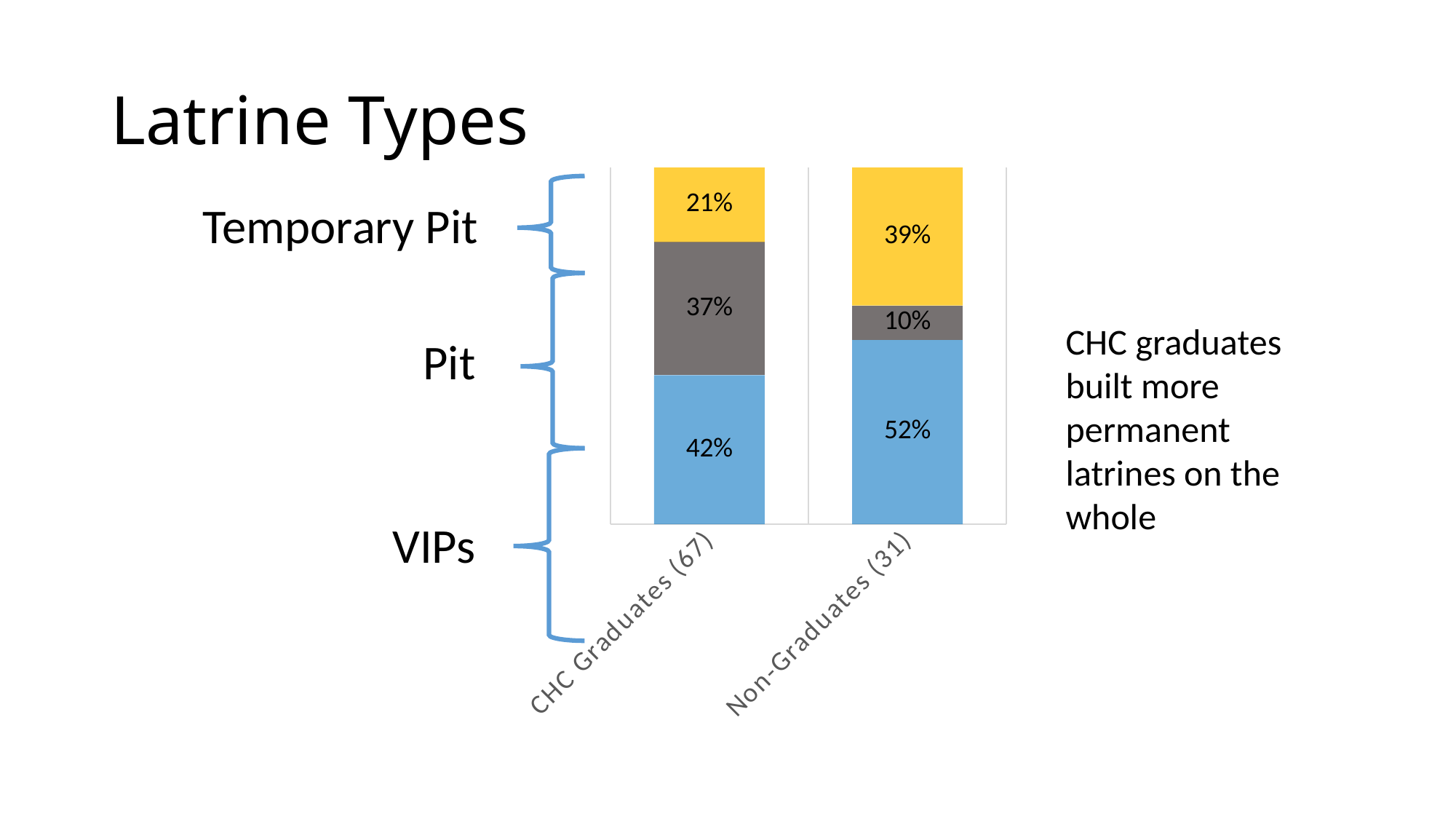
How many latrine types are stacked in each bar? 3 What type of chart is shown on the slide? Stacked bar chart What is the difference between the Temporary Pit share for Non-Graduates and for CHC Graduates? 18% What percentage of Non-Graduates built Temporary Pit latrines? 39% What percentage of CHC Graduates built Pit latrines? 37% What percentage of Non-Graduates built Pit latrines? 10% What is the difference between the Pit share for CHC Graduates and for Non-Graduates? 27% Which latrine type has the largest share among CHC Graduates? VIPs Which group has the higher share of VIPs latrines, CHC Graduates or Non-Graduates? Non-Graduates What percentage of CHC Graduates built VIPs latrines? 42% How many groups (bars) are shown in the chart? 2 Which latrine type has the smallest share among Non-Graduates? Pit